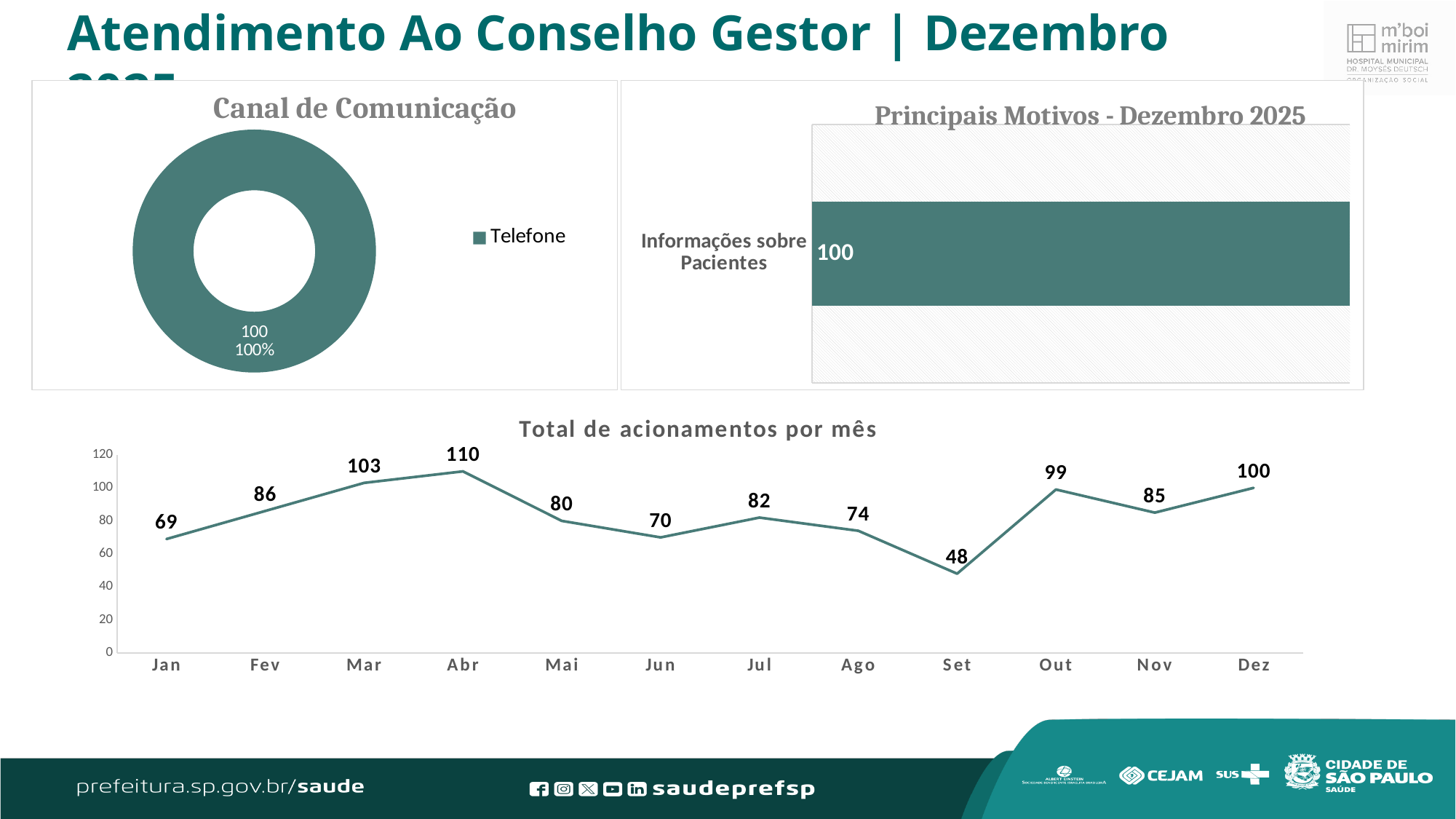
In the 'Total de acionamentos por mês' chart, which month has the lowest value? Set In the 'Total de acionamentos por mês' chart, what is the difference between the values for Dez and Nov? 15 In the 'Total de acionamentos por mês' chart, how many months are plotted? 12 In the 'Total de acionamentos por mês' chart, which month has the highest value? Abr In the 'Principais Motivos - Dezembro 2025' chart, what is the value for Informações sobre Pacientes? 100 In the 'Total de acionamentos por mês' chart, which is larger, the value for Mar or the value for Out? Mar In the 'Canal de Comunicação' chart, what share does Telefone have? 100% In the 'Total de acionamentos por mês' chart, what is the value for Abr? 110 What kind of chart is 'Principais Motivos - Dezembro 2025'? Bar chart In the 'Total de acionamentos por mês' chart, do the values rise or fall from Jan to Abr? Rise In the 'Total de acionamentos por mês' chart, what is the value for Set? 48 What kind of chart is 'Total de acionamentos por mês'? Line chart